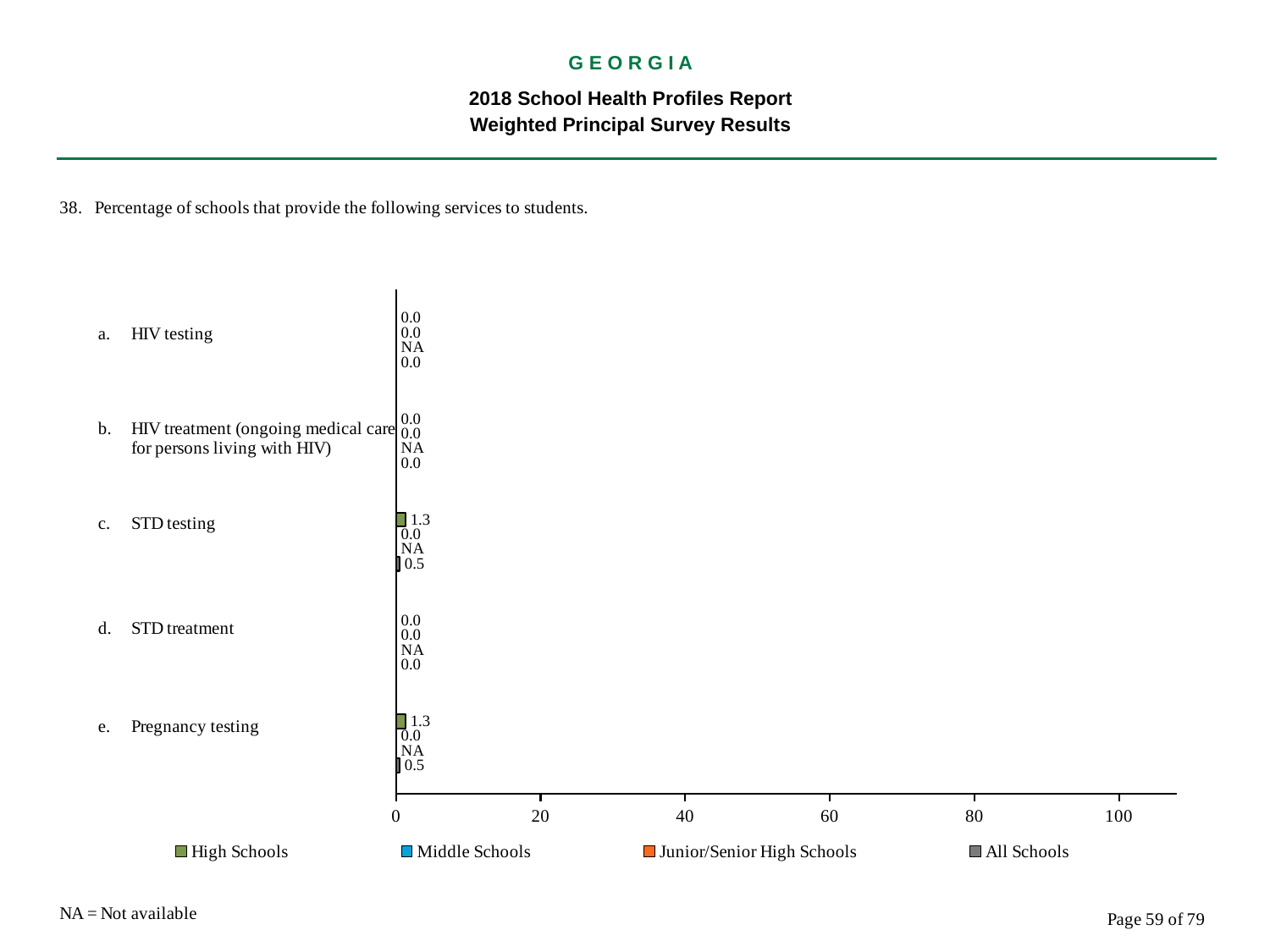
What is the Junior/Senior High Schools value for STD treatment? NA Which is larger for STD testing: the High Schools value or the All Schools value? High Schools What is the High Schools value for STD testing? 1.3 Is the High Schools value for STD testing greater or less than 20? less What kind of chart is shown on the slide? bar chart What is the Middle Schools value for HIV testing? 0.0 How many series does the legend list? 4 What is the High Schools value for HIV treatment (ongoing medical care for persons living with HIV)? 0.0 What does NA stand for according to the note on the slide? Not available What is the difference between the High Schools and All Schools values for Pregnancy testing? 0.8 What is the All Schools value for Pregnancy testing? 0.5 How many service categories are shown on the chart? 5